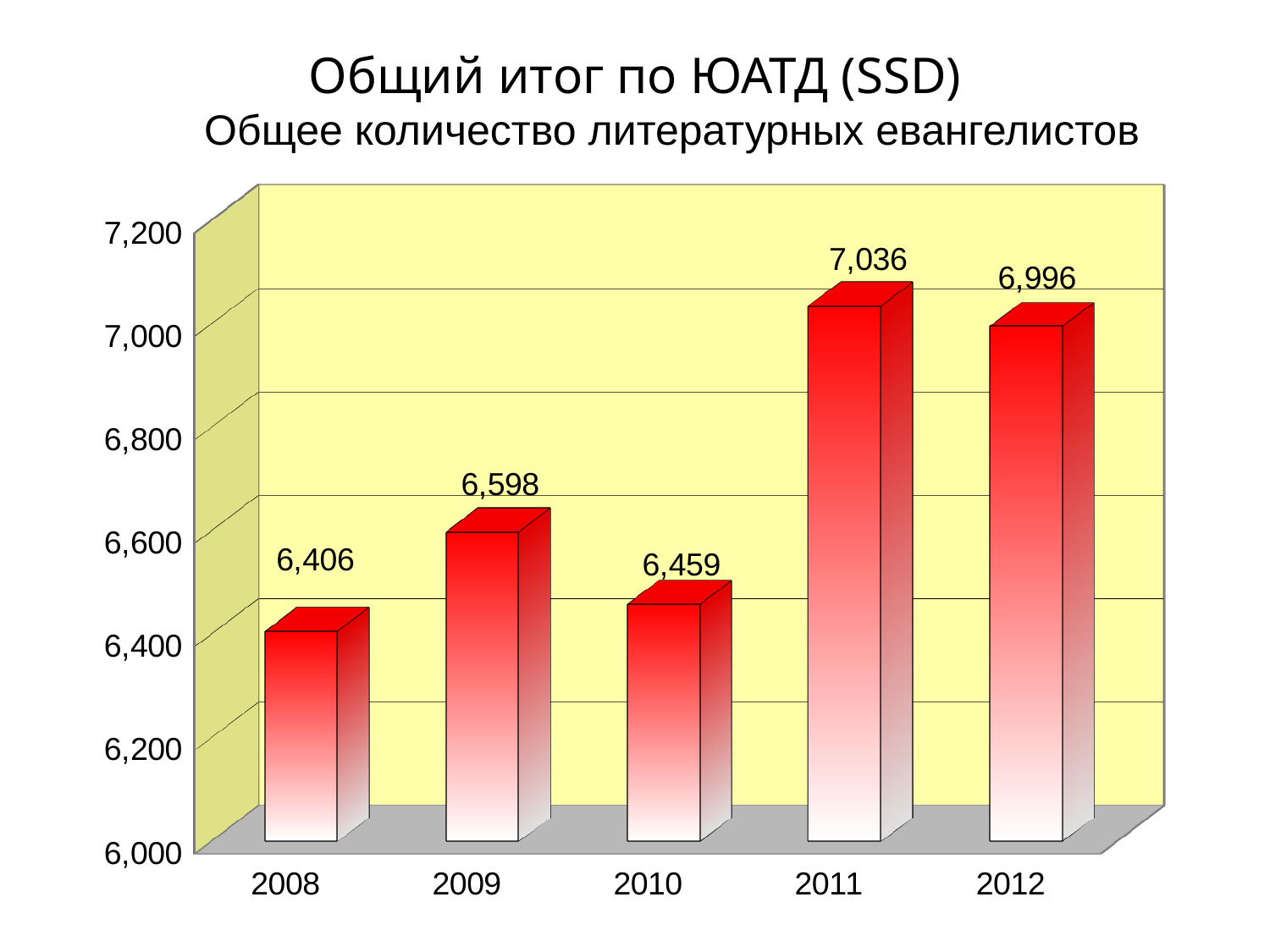
What kind of chart is shown on the slide? bar chart Which is larger, the value for 2009 or the value for 2010? 2009 What is the difference between the values for 2011 and 2012? 40 What is the value for 2011? 7,036 Is the value for 2010 greater or less than 6,600? less What is the value for 2012? 6,996 Which year has the lowest value? 2008 What is the title of the chart? Общий итог по ЮАТД (SSD) Общее количество литературных евангелистов What is the difference between the values for 2009 and 2008? 192 What is the value for 2008? 6,406 How many years are shown on the x axis? 5 Which year has the highest value? 2011